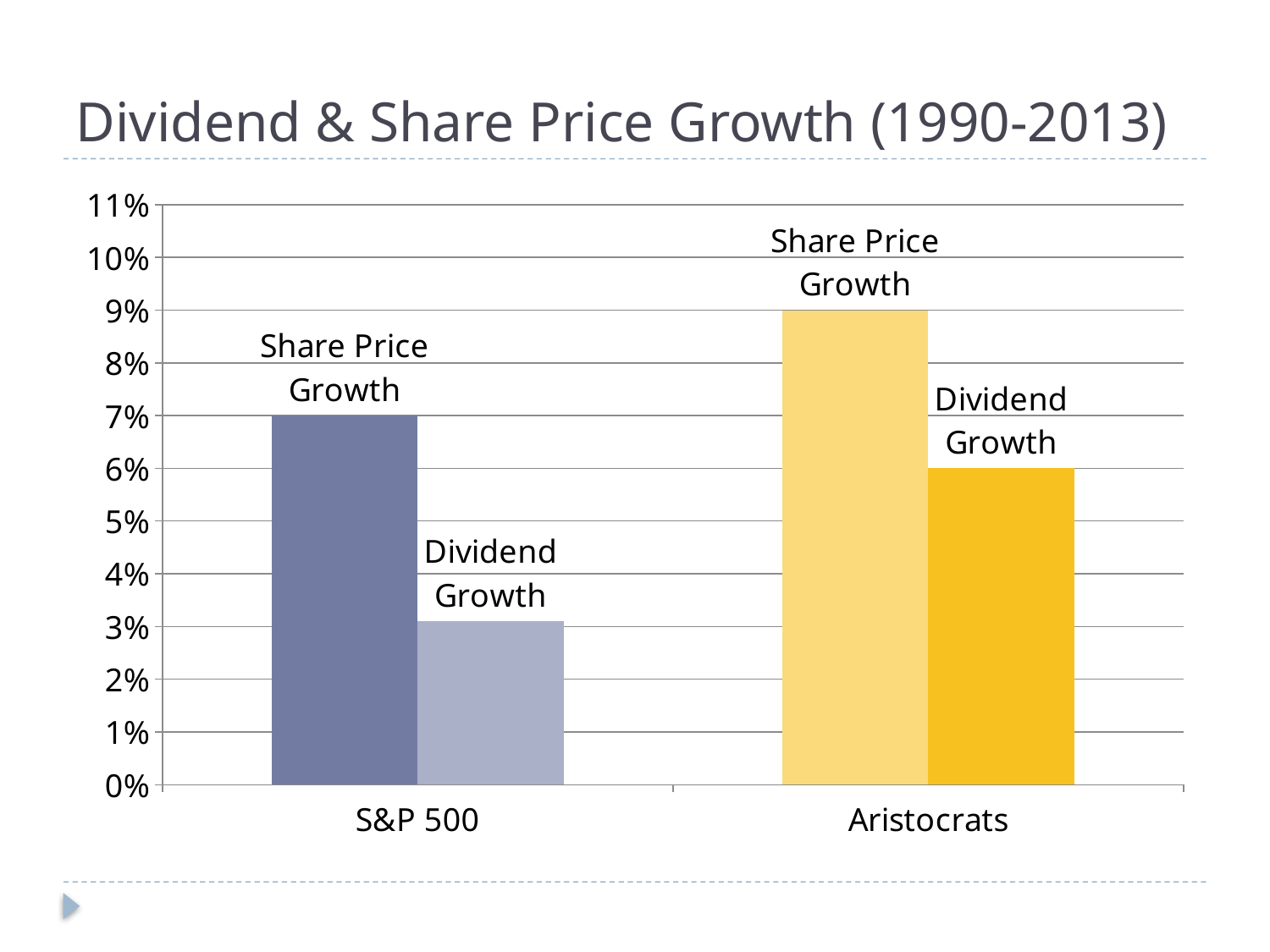
How much higher is Share Price Growth for the Aristocrats than for the S&P 500? 2% What type of chart is shown on the slide? Bar chart What is the Share Price Growth value for the Aristocrats? 9% Which bar on the chart is the lowest? S&P 500 Dividend Growth What is the Share Price Growth value for the S&P 500? 7% Is the Dividend Growth value for the S&P 500 greater or less than 4%? less How many groups are shown on the x axis of the chart? 2 Which group has the higher Dividend Growth, the S&P 500 or the Aristocrats? Aristocrats What is the difference between Share Price Growth and Dividend Growth for the Aristocrats? 3% Is the Dividend Growth value for the S&P 500 greater or less than 2%? greater Which bar on the chart is the highest? Aristocrats Share Price Growth What is the Dividend Growth value for the Aristocrats? 6%